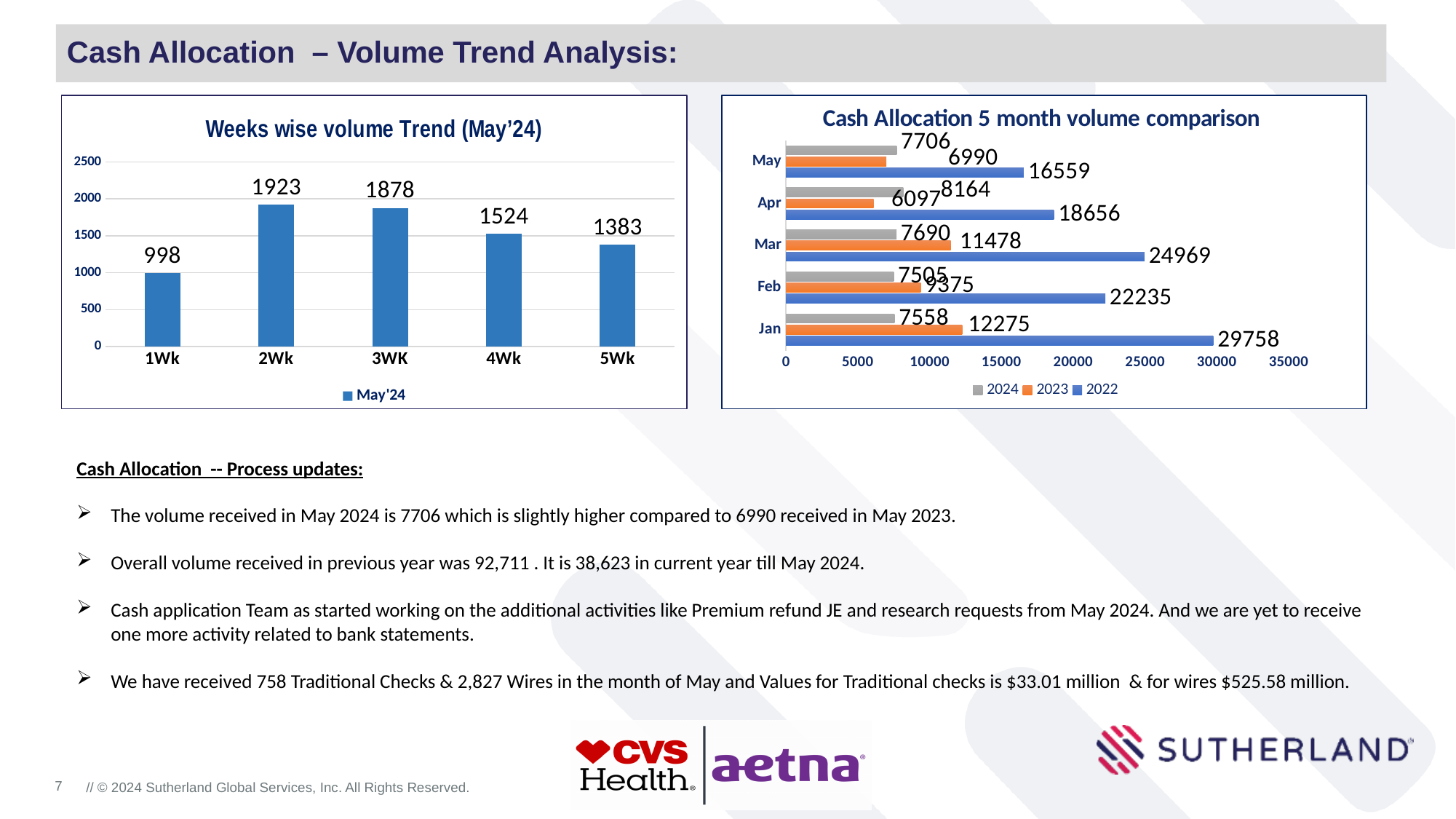
In the 'Weeks wise volume Trend (May'24)' chart, which week has the lowest volume? 1Wk In the 'Cash Allocation 5 month volume comparison' chart, what is the 2022 value for Jan? 29758 In the 'Weeks wise volume Trend (May'24)' chart, do the values rise or fall from 2Wk to 5Wk? fall In the 'Cash Allocation 5 month volume comparison' chart, what is the difference between the 2024 and 2023 values for May? 716 In the 'Cash Allocation 5 month volume comparison' chart, what is the 2023 value for Apr? 6097 In the 'Cash Allocation 5 month volume comparison' chart, which is larger for Mar: the 2023 value or the 2024 value? 2023 In the 'Weeks wise volume Trend (May'24)' chart, how many weeks are plotted? 5 In the 'Weeks wise volume Trend (May'24)' chart, what is the value for 2Wk? 1923 In the 'Cash Allocation 5 month volume comparison' chart, which month has the highest 2024 value? Apr In the 'Weeks wise volume Trend (May'24)' chart, what is the difference between the values for 2Wk and 5Wk? 540 What kind of chart is the 'Weeks wise volume Trend (May'24)' chart? bar chart How many series does the legend of the 'Cash Allocation 5 month volume comparison' chart list? 3